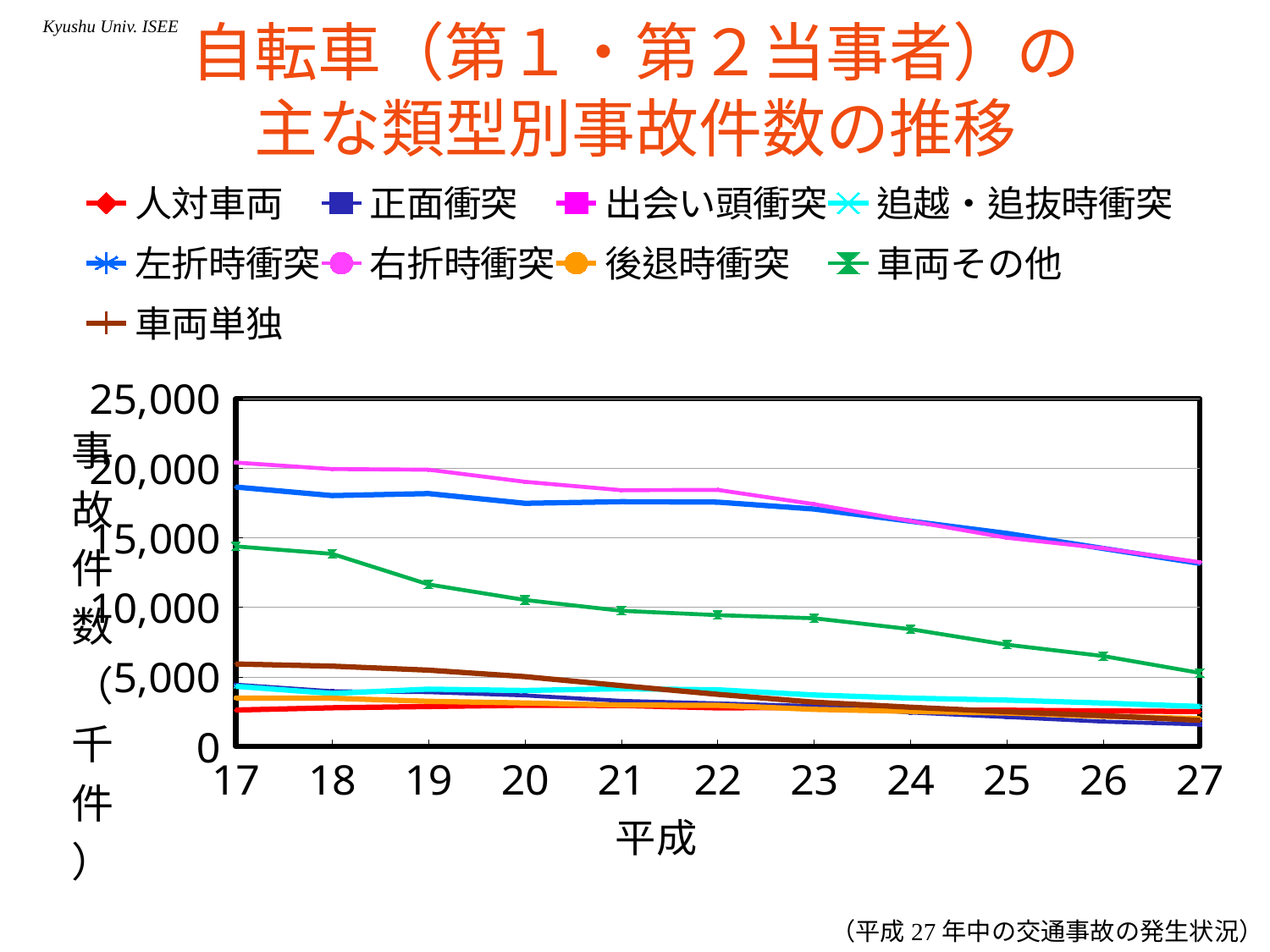
In 平成17, which is larger: 車両その他 or 車両単独? 車両その他 Is the value for 車両その他 in 平成20 greater or less than 15,000? less What kind of chart is shown on the slide? line chart Does the value for 車両単独 rise or fall from 平成17 to 平成27? fall Does the value for 車両その他 rise or fall from 平成17 to 平成27? fall How many series does the legend list? 9 What is the label of the x axis? 平成 Is the value for 車両その他 in 平成24 greater or less than 5,000? greater Is the value for 車両その他 in 平成17 greater or less than 10,000? greater How many years are plotted along the x axis? 11